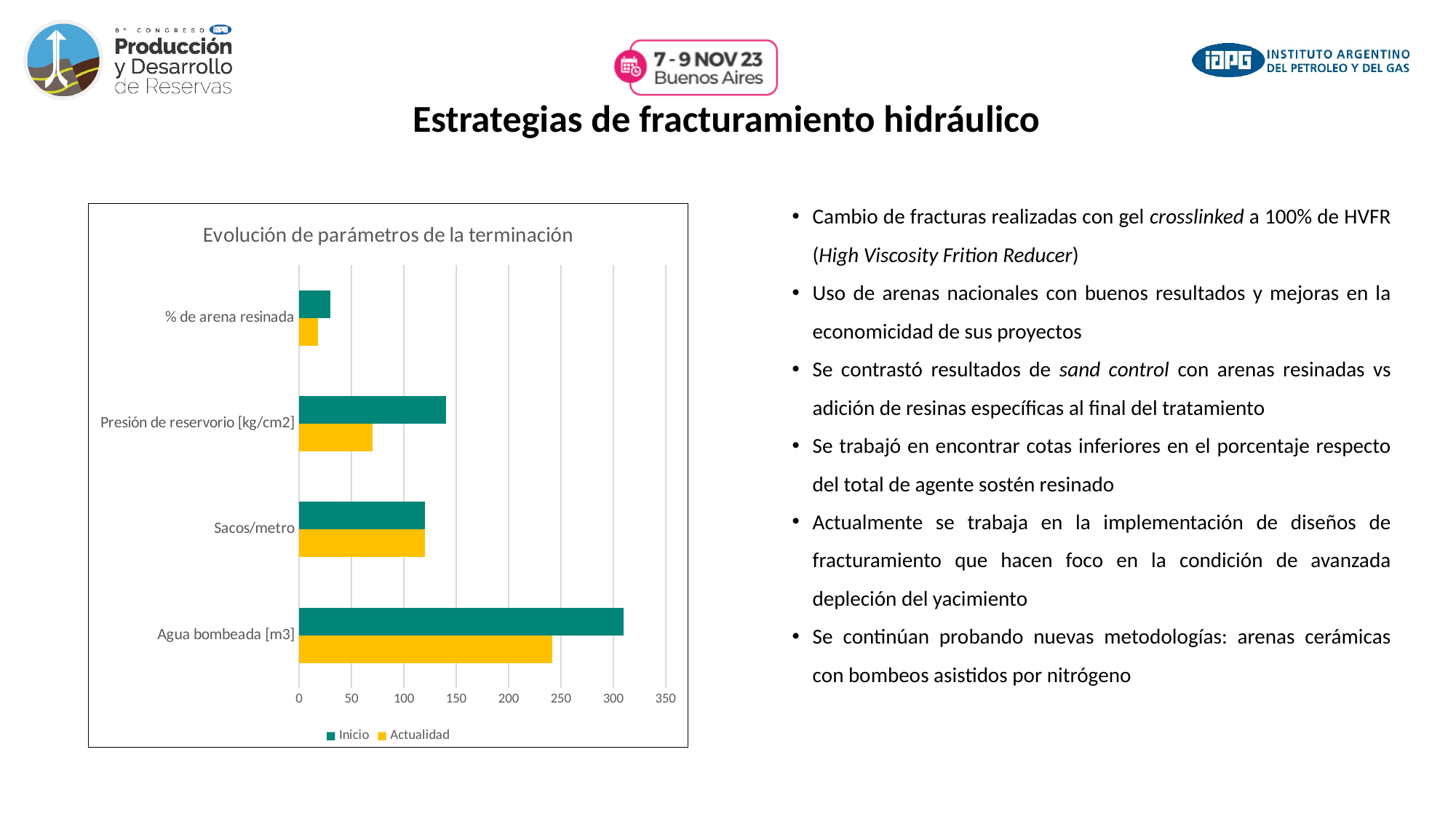
Is the Actualidad value for Presión de reservorio [kg/cm2] greater or less than 100? less Is the Inicio value for Agua bombeada [m3] greater or less than 250? greater Which series is shown in yellow in the legend? Actualidad How many series does the chart legend list? 2 For Agua bombeada [m3], which is larger, Inicio or Actualidad? Inicio Which category has the lowest Actualidad value? % de arena resinada Is the Inicio value for Sacos/metro greater or less than 100? greater How many categories are shown on the chart? 4 What is the title of the chart? Evolución de parámetros de la terminación Which category has the highest Inicio value? Agua bombeada [m3] For Presión de reservorio [kg/cm2], which is larger, Inicio or Actualidad? Inicio What type of chart is shown on the slide? bar chart